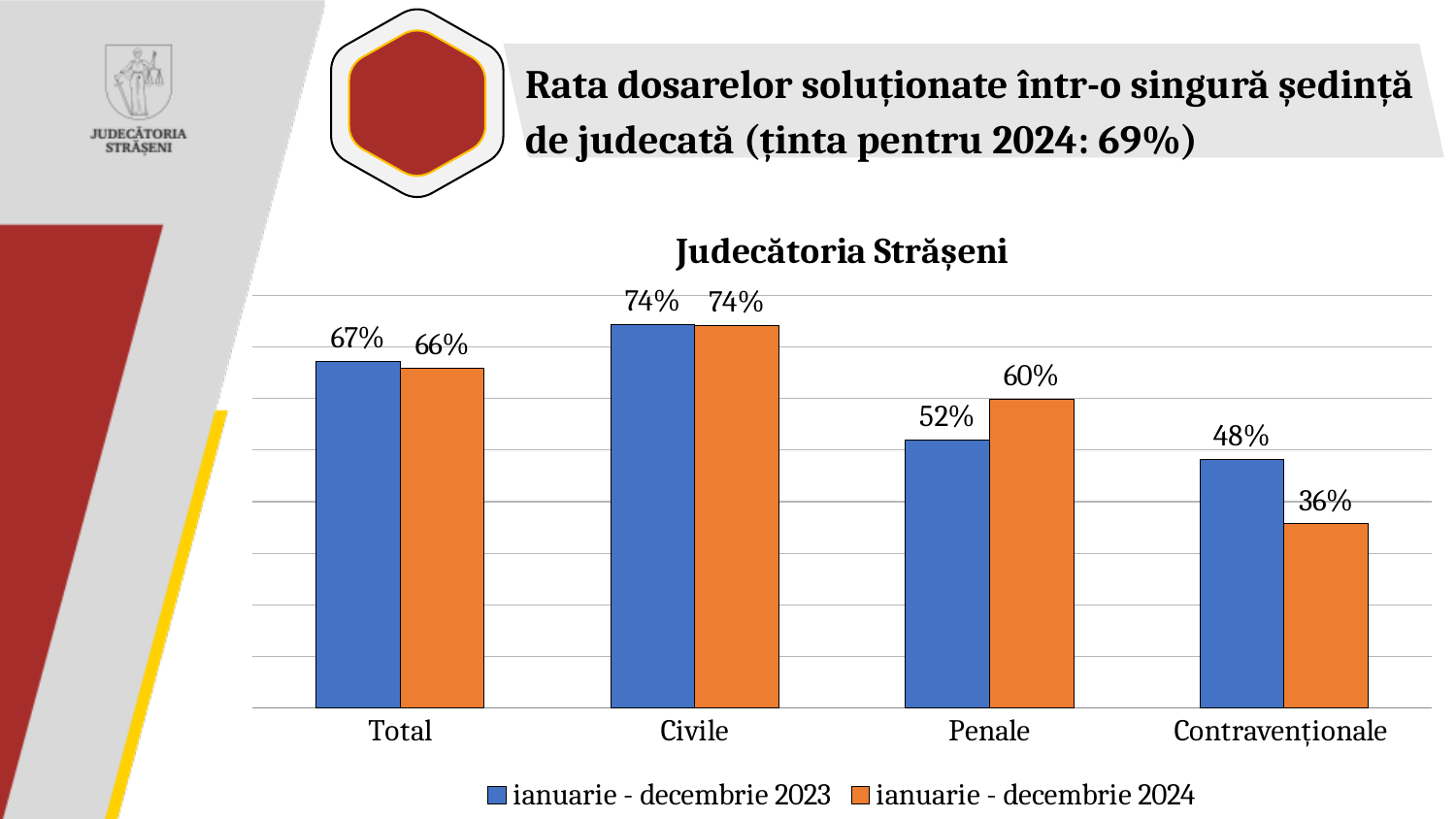
What is the value for Civile in the ianuarie - decembrie 2024 series? 74% How many series does the legend list? 2 How many categories are shown on the x axis? 4 Which category has the highest value in the ianuarie - decembrie 2023 series? Civile What kind of chart is shown on the slide? bar chart What is the difference between the 2023 and 2024 values for Total? 1% Which category has the lowest value in the ianuarie - decembrie 2024 series? Contravenționale What is the value for Contravenționale in the ianuarie - decembrie 2024 series? 36% Which is larger for Contravenționale: the ianuarie - decembrie 2023 value or the ianuarie - decembrie 2024 value? ianuarie - decembrie 2023 What is the value for Penale in the ianuarie - decembrie 2023 series? 52% What is the title of the chart? Judecătoria Strășeni What is the difference between the 2024 and 2023 values for Penale? 8%